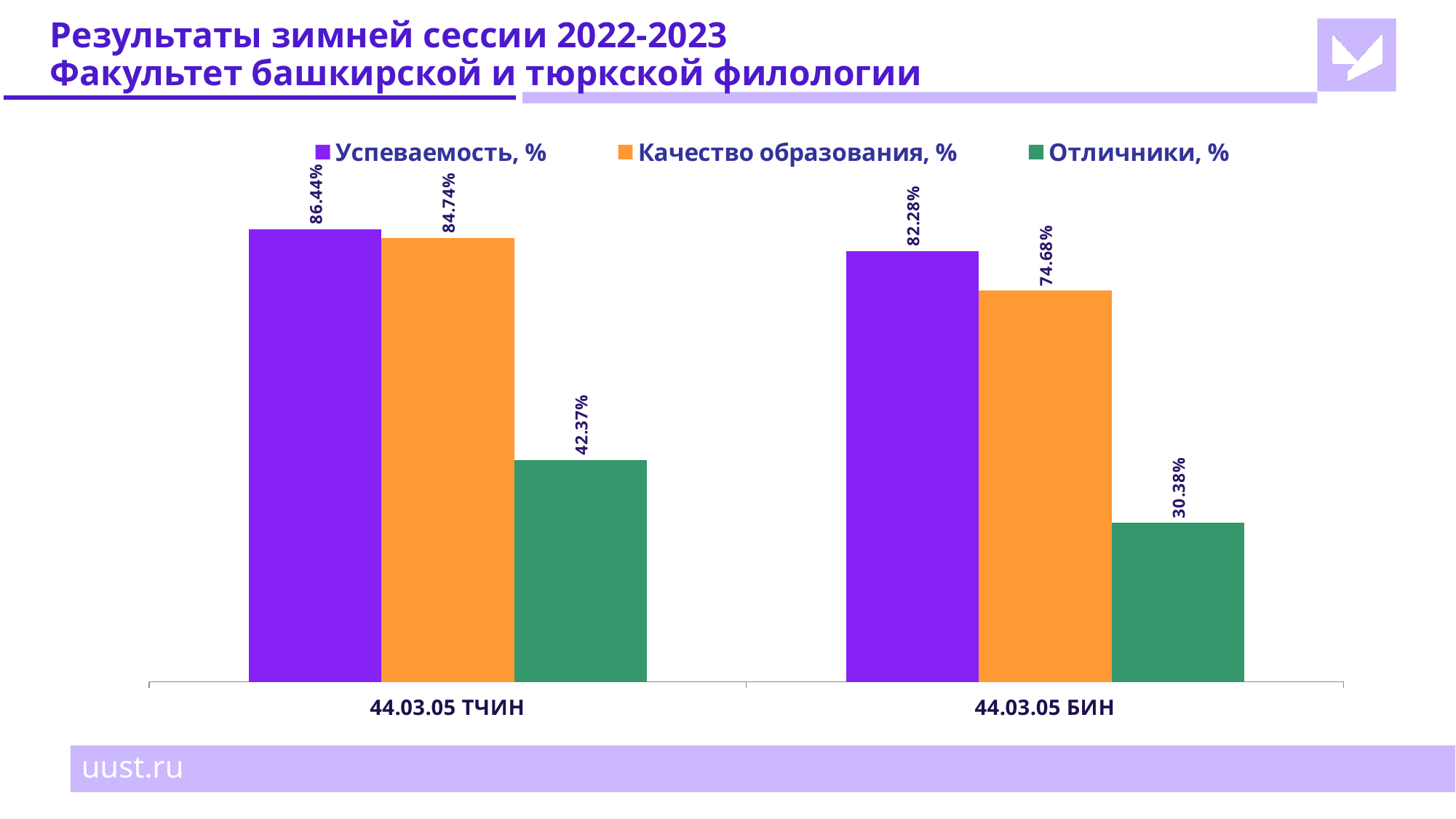
What kind of chart is shown on the slide? Bar chart What is the value of Качество образования, % for 44.03.05 БИН? 74.68% How many series does the legend list? 3 What is the value of Успеваемость, % for 44.03.05 ТЧИН? 86.44% What is the value of Отличники, % for 44.03.05 ТЧИН? 42.37% How many categories are shown on the x axis? 2 What is the value of Отличники, % for 44.03.05 БИН? 30.38% Which series has the lowest value for 44.03.05 БИН? Отличники, % What is the difference between Отличники, % for 44.03.05 ТЧИН and for 44.03.05 БИН? 11.99% What is the difference between Успеваемость, % and Качество образования, % for 44.03.05 БИН? 7.60% Which is larger: Качество образования, % for 44.03.05 ТЧИН or for 44.03.05 БИН? 44.03.05 ТЧИН Which category has the higher value for Успеваемость, %? 44.03.05 ТЧИН